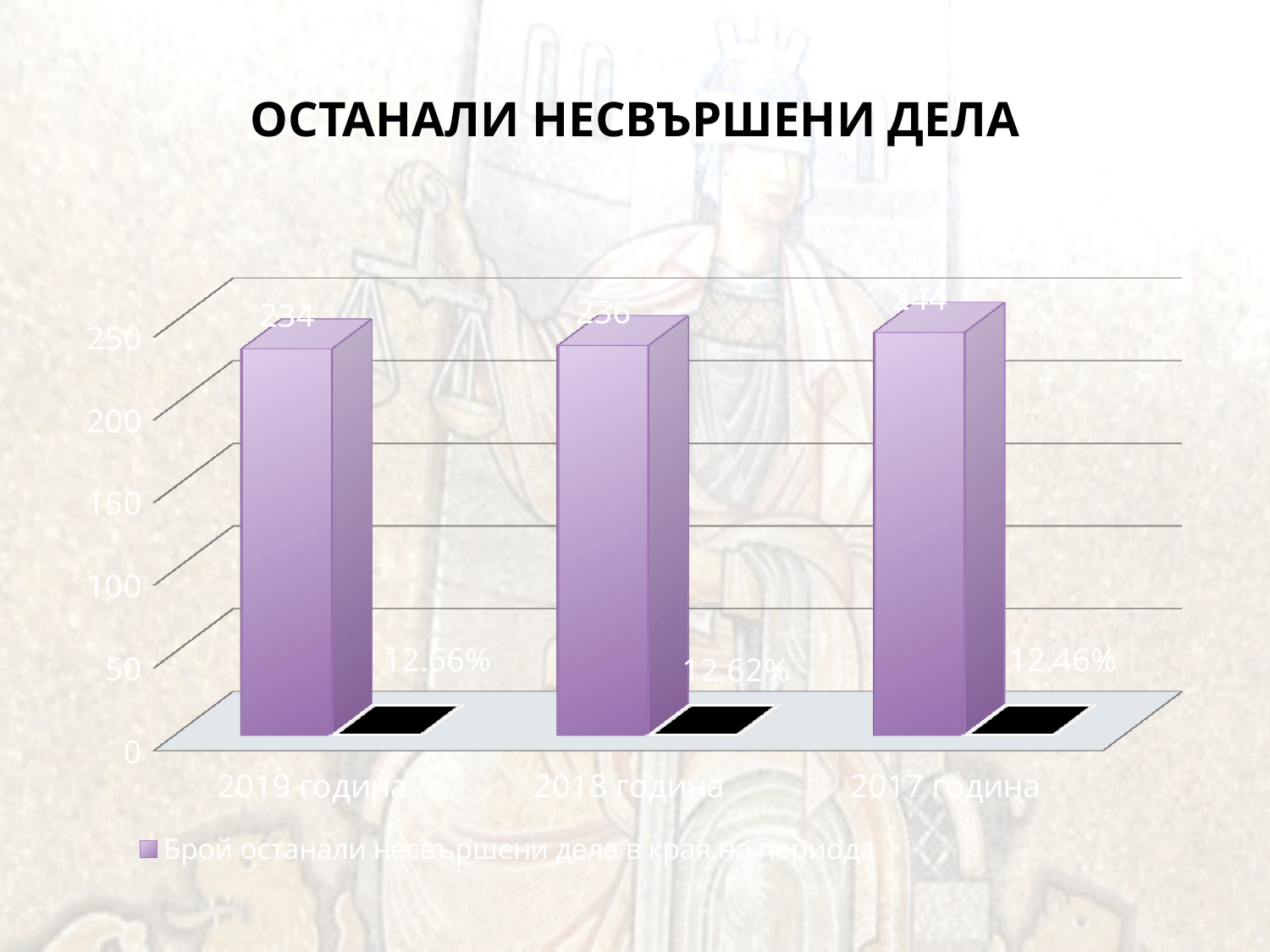
What is the difference between the values for 2017 година and 2019 година? 10 What is the value for 2019 година in the chart? 234 What is the value for 2018 година in the chart? 236 Which year has the highest number of remaining unfinished cases? 2017 година What kind of chart is shown on the slide? bar chart Which is larger, the value for 2018 година or the value for 2017 година? 2017 година What is the value for 2017 година in the chart? 244 What is the title of the slide? ОСТАНАЛИ НЕСВЪРШЕНИ ДЕЛА How many year categories are shown on the x axis? 3 What percentage label is shown for 2019 година? 12.66% What percentage label is shown for 2017 година? 12.46% Which year has the lowest number of remaining unfinished cases? 2019 година